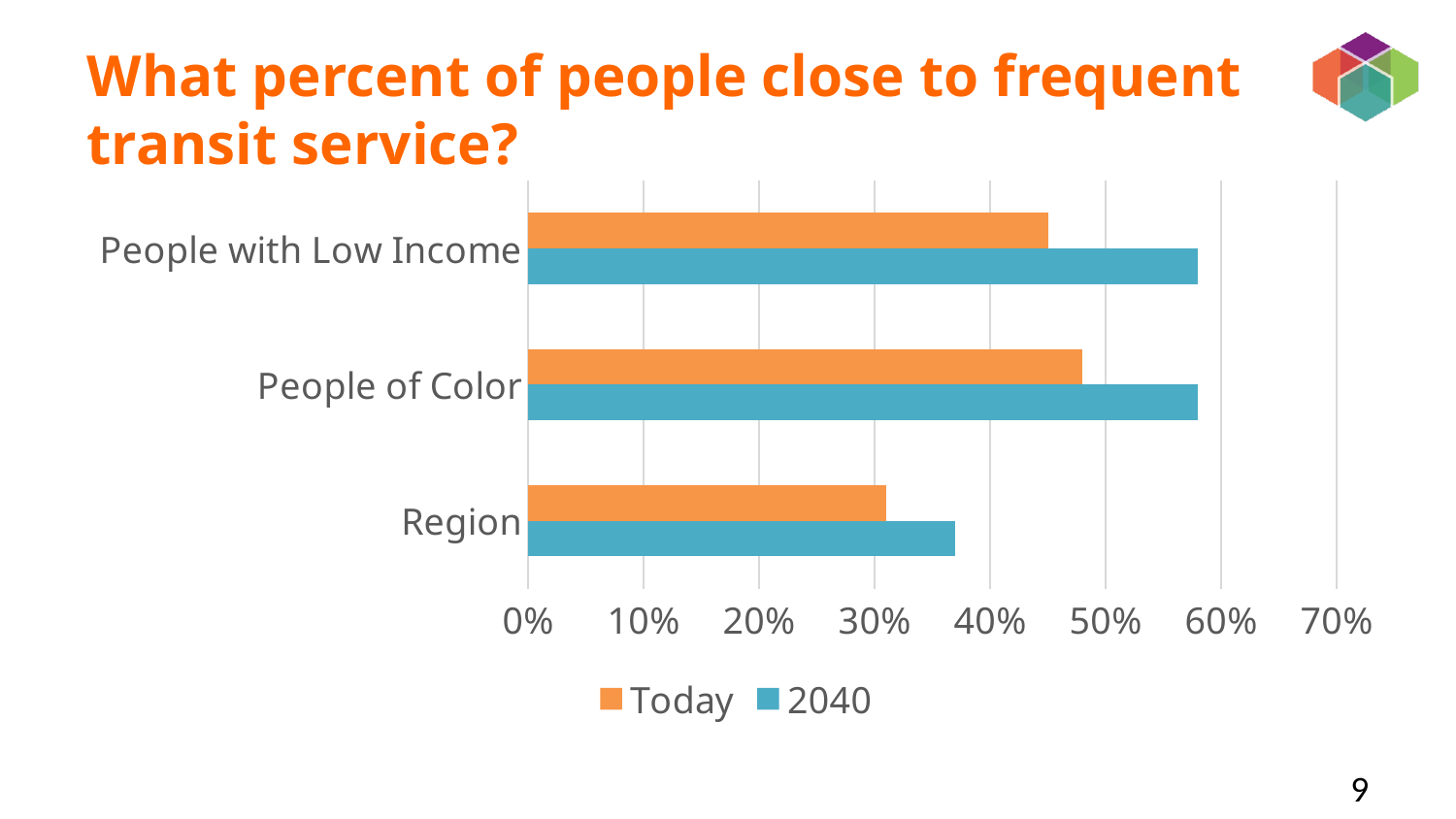
How many series does the legend list? 2 Is the Today value for Region greater or less than 40%? less Which category has the lowest Today value? Region For Region, which is larger: the Today value or the 2040 value? 2040 Is the Today value for People of Color greater or less than 40%? greater What is the title of the chart? What percent of people close to frequent transit service? Is the 2040 value for Region greater or less than 30%? greater What are the two series listed in the legend? Today and 2040 What kind of chart is shown on the slide? bar chart How many categories are shown on the chart? 3